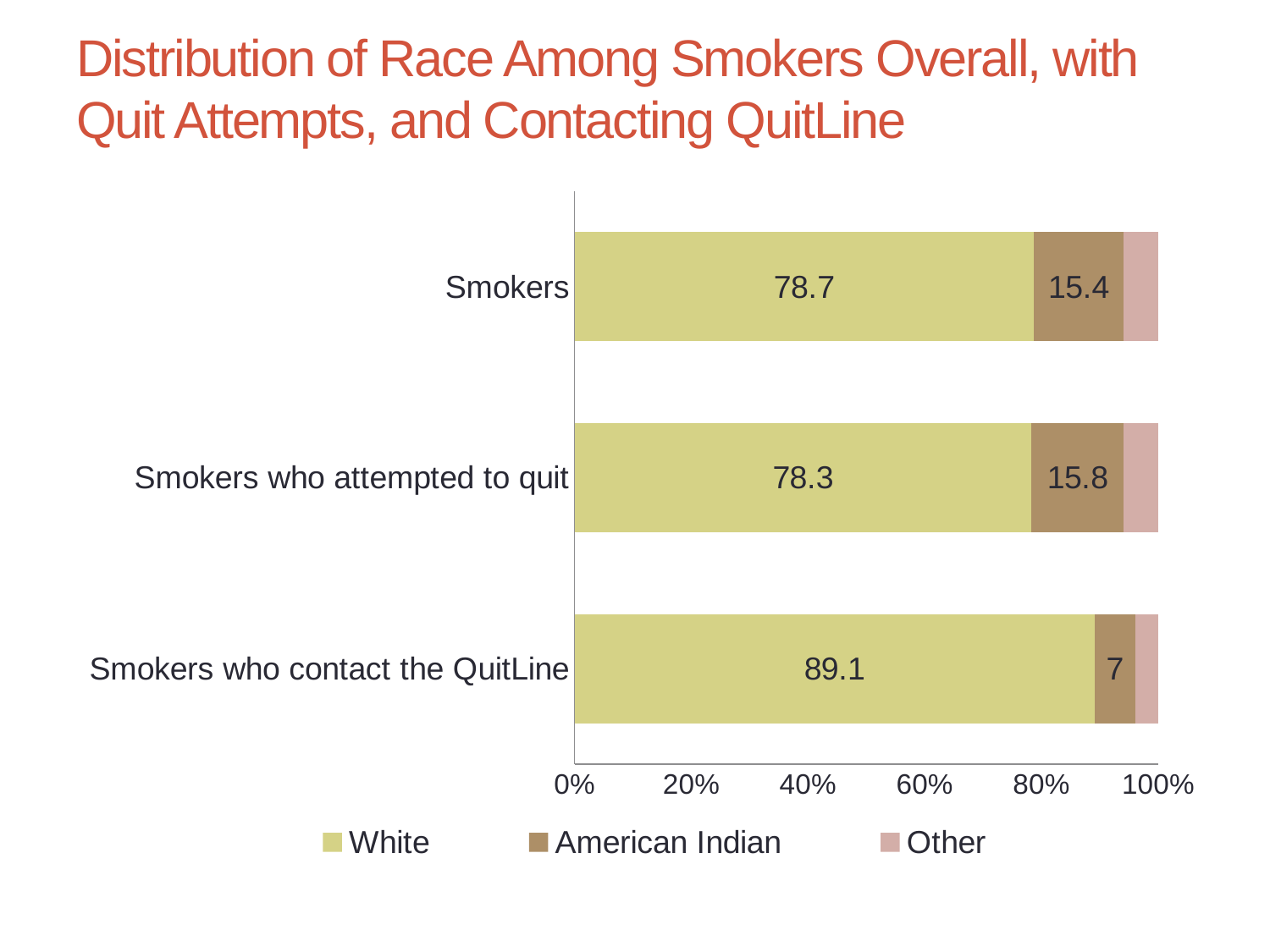
What is the White share for Smokers? 78.7 Which category has the lowest American Indian share? Smokers who contact the QuitLine Which category has the highest White share? Smokers who contact the QuitLine Which is larger: the American Indian share for Smokers or for Smokers who attempted to quit? Smokers who attempted to quit What is the difference between the White share for Smokers who contact the QuitLine and the White share for Smokers? 10.4 What is the American Indian share for Smokers who attempted to quit? 15.8 What is the American Indian share for Smokers who contact the QuitLine? 7 What is the White share for Smokers who contact the QuitLine? 89.1 How many series does the legend list? 3 How many categories are shown on the chart? 3 What kind of chart is shown on the slide? Stacked bar chart Is the Other share for Smokers greater or less than 20%? less